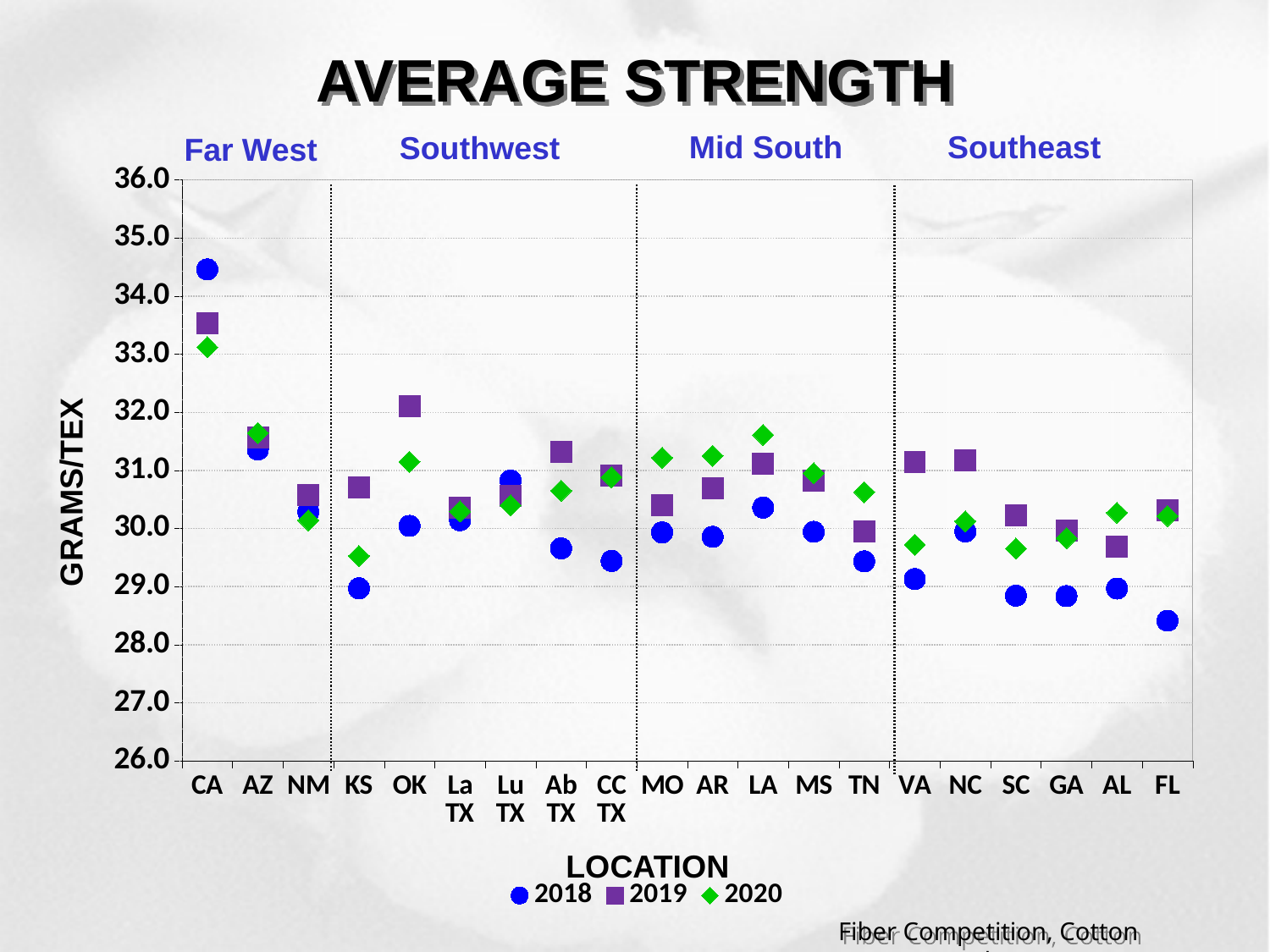
For OK, which is larger, the 2018 value or the 2019 value? 2019 Is the 2020 value for KS greater or less than 30.0? less How many series does the legend list? 3 Which location has the highest 2018 value? CA How many locations are plotted along the x axis? 20 Which location has the highest 2019 value? CA What is the title of the chart? AVERAGE STRENGTH What kind of chart is shown on the slide? scatter chart Which location has the lowest 2018 value? FL Is the 2018 value for CA greater or less than 34.0? greater What is the label of the y axis? GRAMS/TEX Is the 2018 value for FL greater or less than 29.0? less